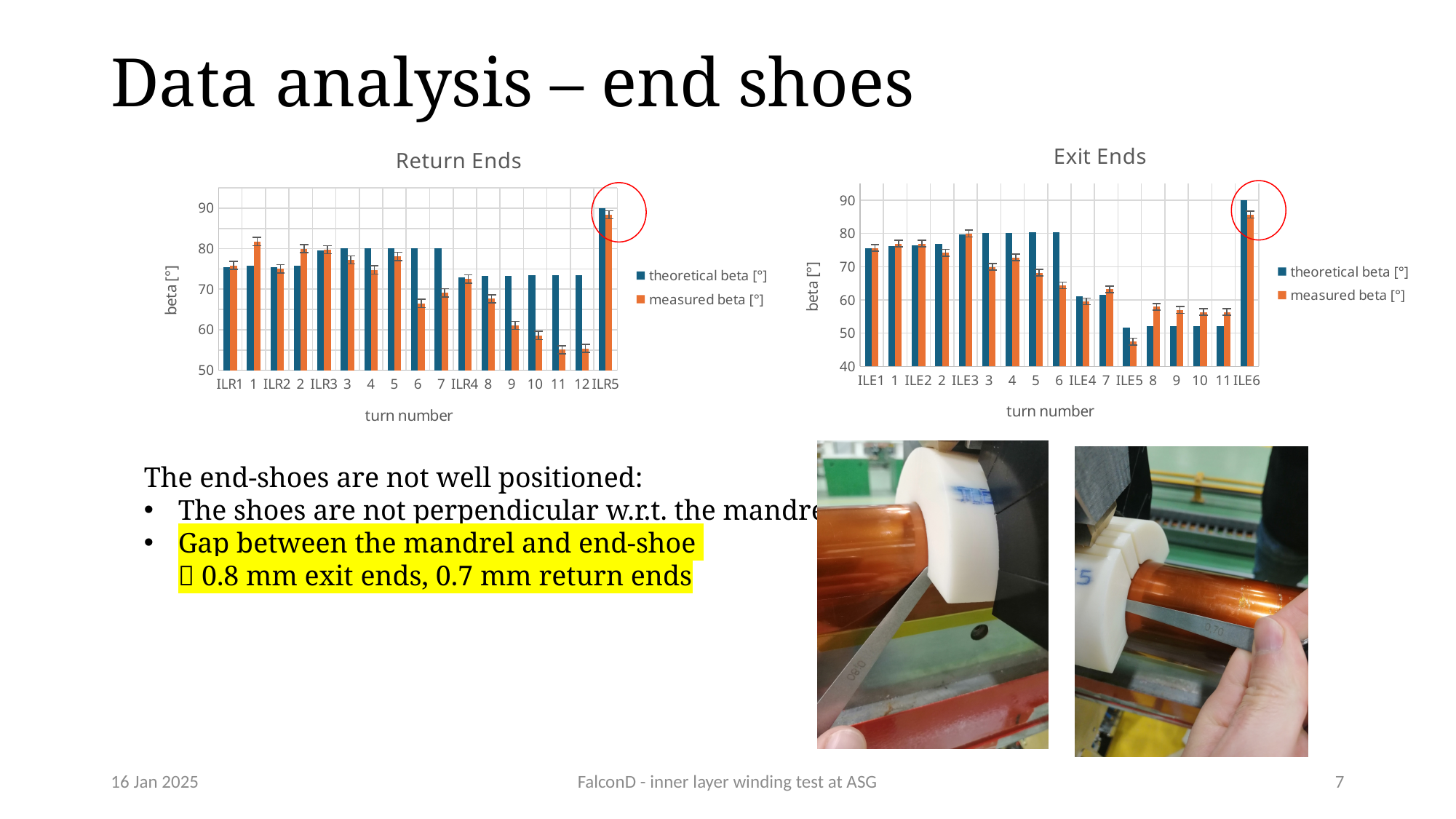
What kind of chart is the Return Ends chart? bar chart How many turn-number categories are shown on the x axis of the Exit Ends chart? 17 What is the label of the y axis on the Exit Ends chart? beta [°] In the Return Ends chart, which category has the highest theoretical beta? ILR5 How many series does the legend of the Exit Ends chart list? 2 How many turn-number categories are shown on the x axis of the Return Ends chart? 17 In the Return Ends chart, for turn 9, which is larger: the theoretical beta or the measured beta? theoretical beta In the Exit Ends chart, is the measured beta for ILE5 greater or less than 50? less In the Exit Ends chart, which category has the lowest measured beta? ILE5 In the Exit Ends chart, is the measured beta for ILE6 greater or less than 80? greater In the Exit Ends chart, which category has the highest measured beta? ILE6 In the Return Ends chart, is the measured beta for turn 11 greater or less than 60? less